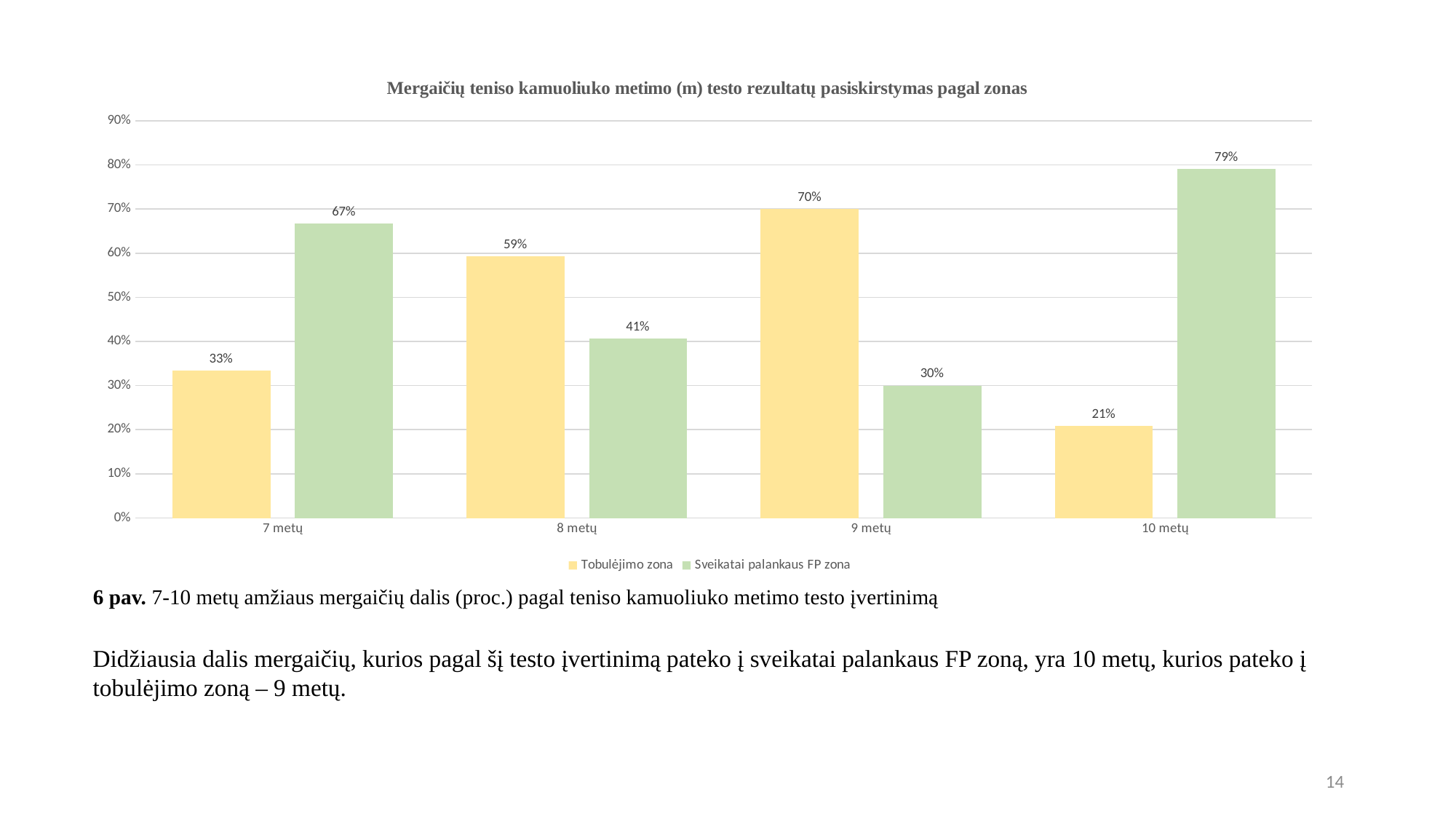
Is the value for Tobulėjimo zona at 9 metų greater or less than 60%? greater What is the value for Tobulėjimo zona at 7 metų? 33% What is the value for Sveikatai palankaus FP zona at 10 metų? 79% What is the title of the chart? Mergaičių teniso kamuoliuko metimo (m) testo rezultatų pasiskirstymas pagal zonas At 8 metų, which series has the larger value, Tobulėjimo zona or Sveikatai palankaus FP zona? Tobulėjimo zona What is the value for Sveikatai palankaus FP zona at 8 metų? 41% How many age groups are shown on the x axis? 4 Which age group has the lowest value for Sveikatai palankaus FP zona? 9 metų What is the difference between the Sveikatai palankaus FP zona and Tobulėjimo zona values at 10 metų? 58% Which age group has the highest value for Tobulėjimo zona? 9 metų How many series does the legend list? 2 What kind of chart is shown on the slide? bar chart